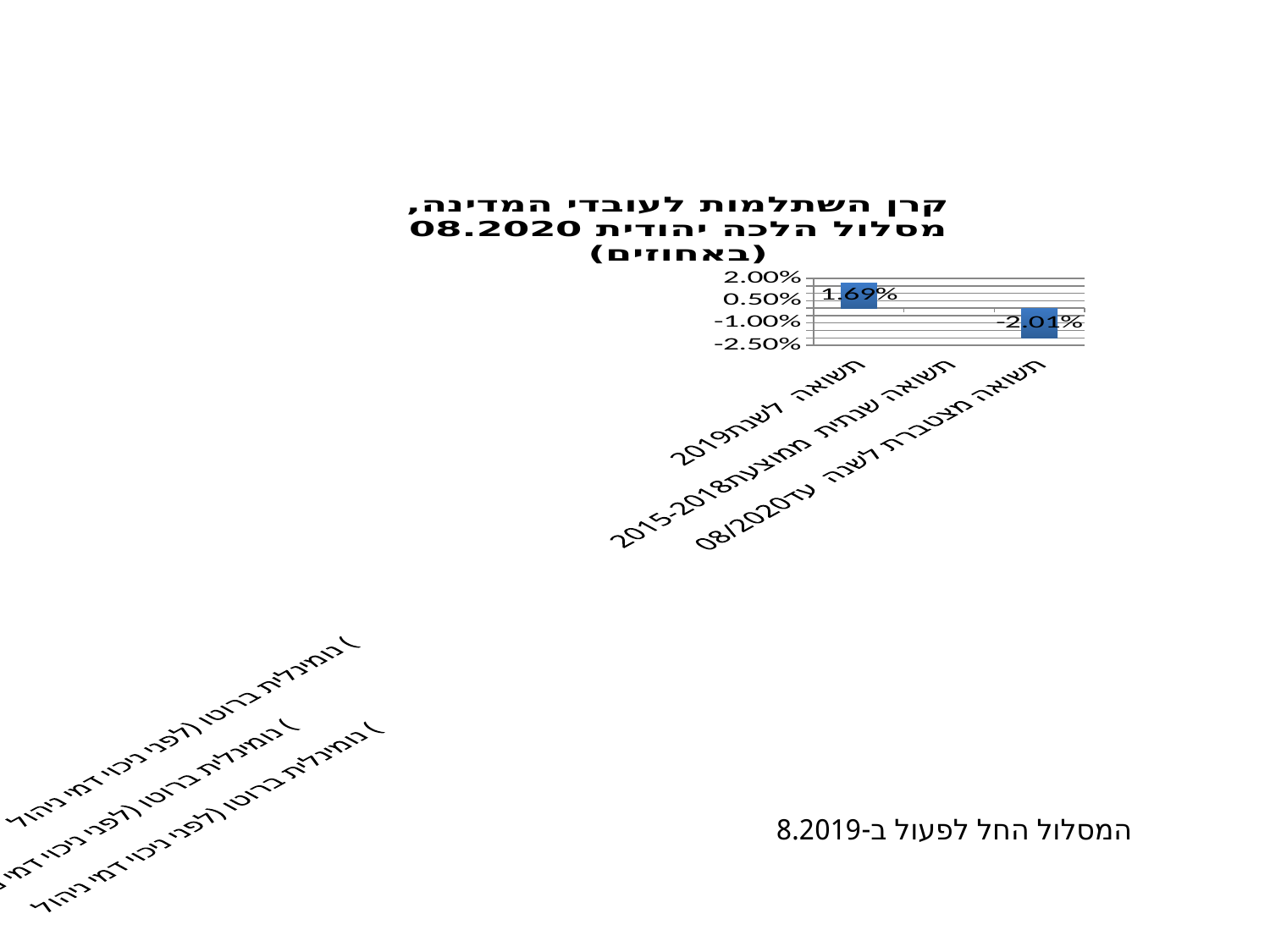
What is the lowest value shown on the y axis of the chart? -2.50% Is the value for תשואה מצטברת לשנה עד 08/2020 greater or less than -1.00%? less What is the value for תשואה לשנת 2019? 1.69% What is the value for תשואה מצטברת לשנה עד 08/2020? -2.01% What is the title of the chart? קרן השתלמות לעובדי המדינה, מסלול הלכה יהודית 08.2020 (באחוזים) Which category has the lowest value? תשואה מצטברת לשנה עד 08/2020 What kind of chart is shown on the slide? bar chart Which is larger, the value for תשואה לשנת 2019 or the value for תשואה מצטברת לשנה עד 08/2020? תשואה לשנת 2019 Is the value for תשואה לשנת 2019 greater or less than 0.50%? greater What is the difference between the value for תשואה לשנת 2019 and the value for תשואה מצטברת לשנה עד 08/2020? 3.70% Which category has the highest value? תשואה לשנת 2019 How many categories are shown on the x axis of the chart? 3